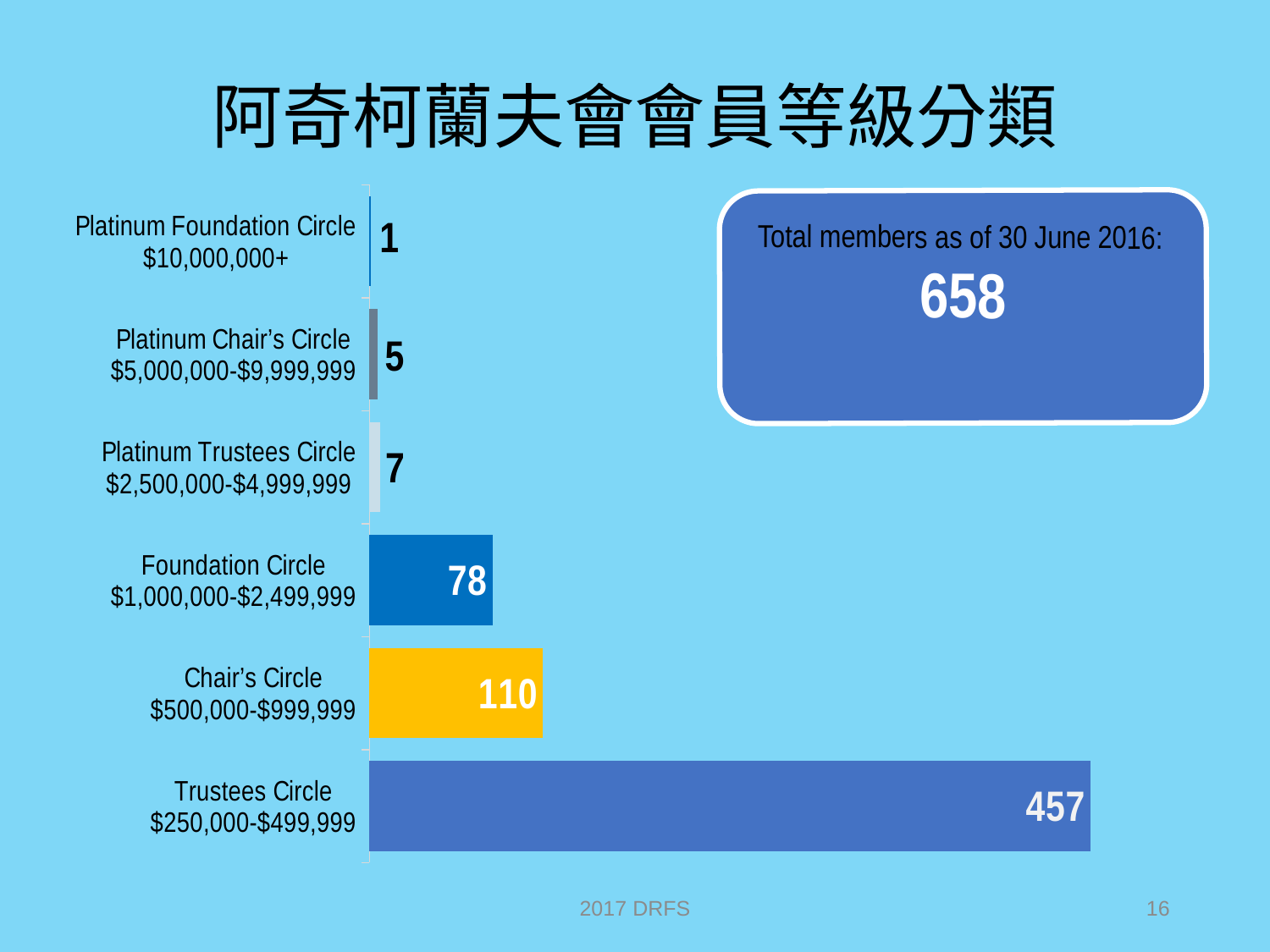
What is the difference in members between the Platinum Trustees Circle and the Platinum Chair's Circle? 2 What is the total number of members as of 30 June 2016 stated on the slide? 658 How many members are in the Foundation Circle ($1,000,000-$2,499,999)? 78 What is the difference in members between the Trustees Circle and the Chair's Circle? 347 How many members are in the Chair's Circle ($500,000-$999,999)? 110 How many membership levels are shown in the chart? 6 Which membership level has the fewest members? Platinum Foundation Circle Which membership level has the most members? Trustees Circle Which has more members, the Foundation Circle or the Chair's Circle? Chair's Circle How many members are in the Platinum Chair's Circle? 5 How many members are in the Trustees Circle ($250,000-$499,999)? 457 What kind of chart is shown on the slide? Bar chart